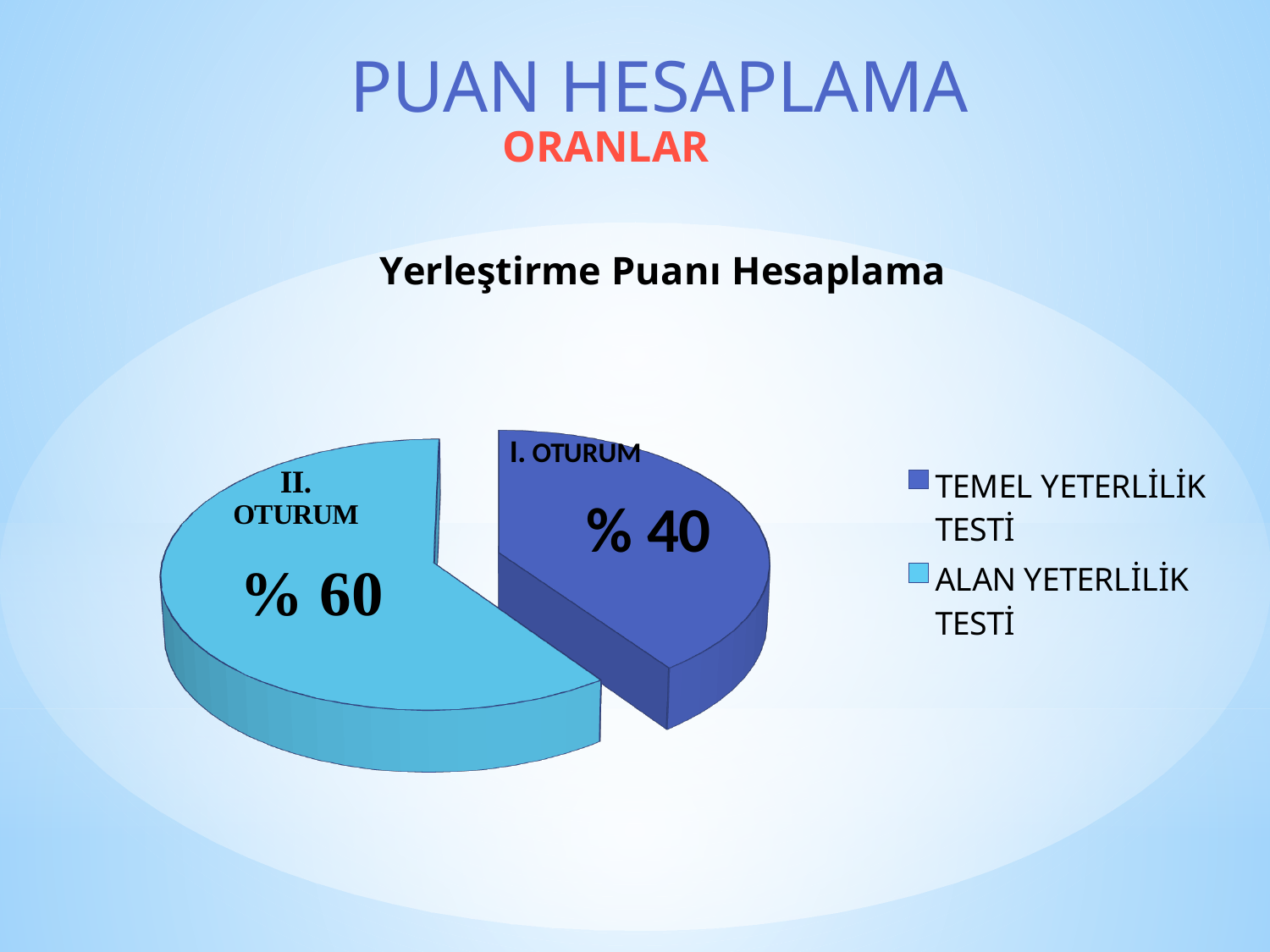
Which slice is the largest? ALAN YETERLİLİK TESTİ (II. OTURUM) What value is labelled on the II. OTURUM slice? % 60 What is the title of the chart? Yerleştirme Puanı Hesaplama What share of the pie does TEMEL YETERLİLİK TESTİ (I. OTURUM) take? % 40 What kind of chart is shown on the slide? Pie chart What value is labelled on the I. OTURUM slice? % 40 How many slices does the pie chart have? 2 What share of the pie does ALAN YETERLİLİK TESTİ (II. OTURUM) take? % 60 What is the difference between the II. OTURUM share and the I. OTURUM share? 20 percentage points Which slice is the smallest? TEMEL YETERLİLİK TESTİ (I. OTURUM) Which legend entry is shown in light blue? ALAN YETERLİLİK TESTİ How many entries does the legend list? 2